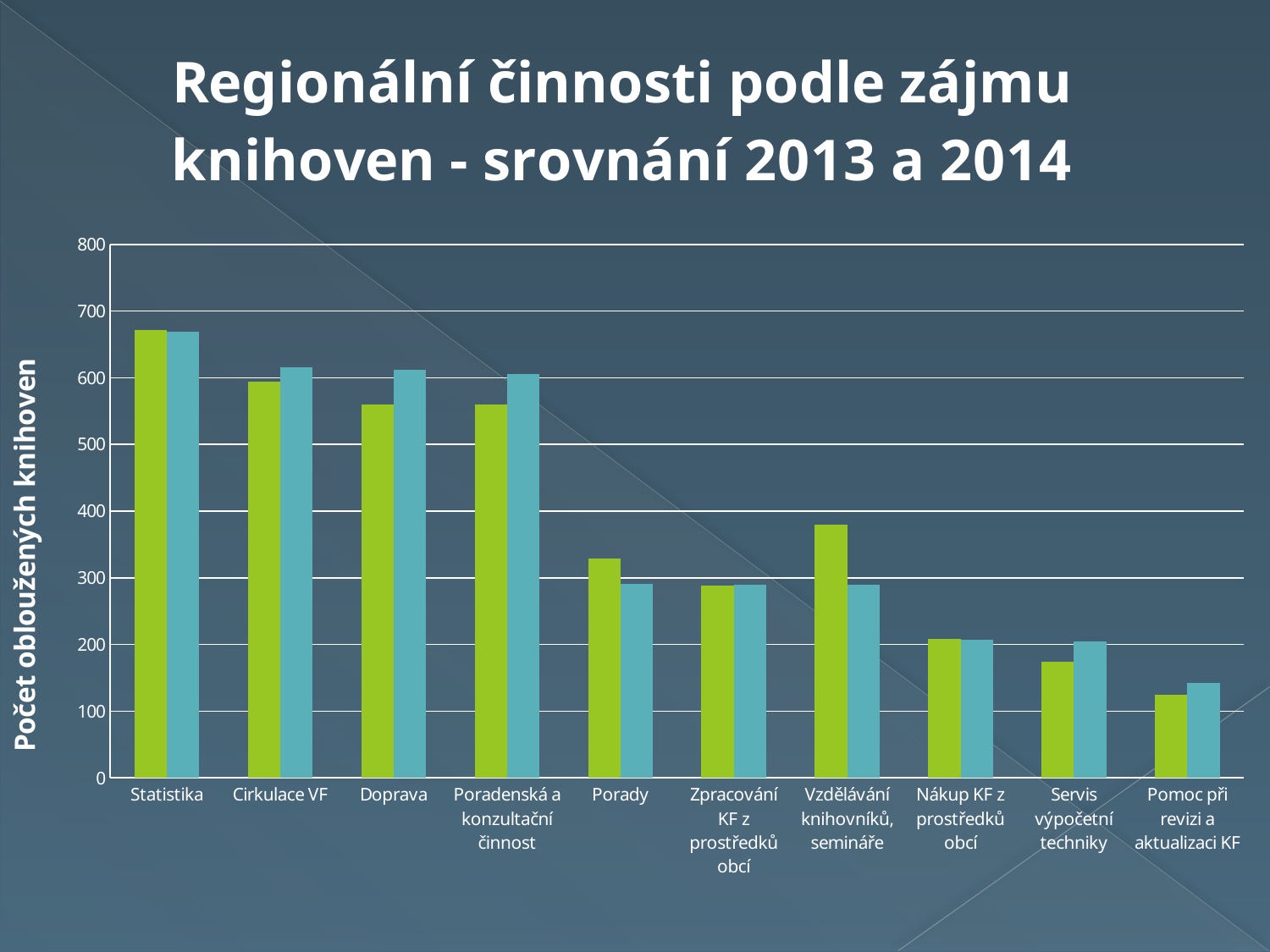
Is the green bar for Vzdělávání knihovníků, semináře greater or less than 300? greater Which category has the shortest green bar? Pomoc při revizi a aktualizaci KF Is the green bar for Servis výpočetní techniky greater or less than 200? less For Doprava, which bar is taller, the green one or the blue one? blue Is the green bar for Statistika greater or less than 600? greater For Vzdělávání knihovníků, semináře, which bar is taller, the green one or the blue one? green How many bars are plotted for each category in the chart? 2 How many categories are shown on the x axis of the chart? 10 What kind of chart is shown on the slide? bar chart Which category has the tallest green bar? Statistika What is the title of the vertical axis of the chart? Počet obloužených knihoven